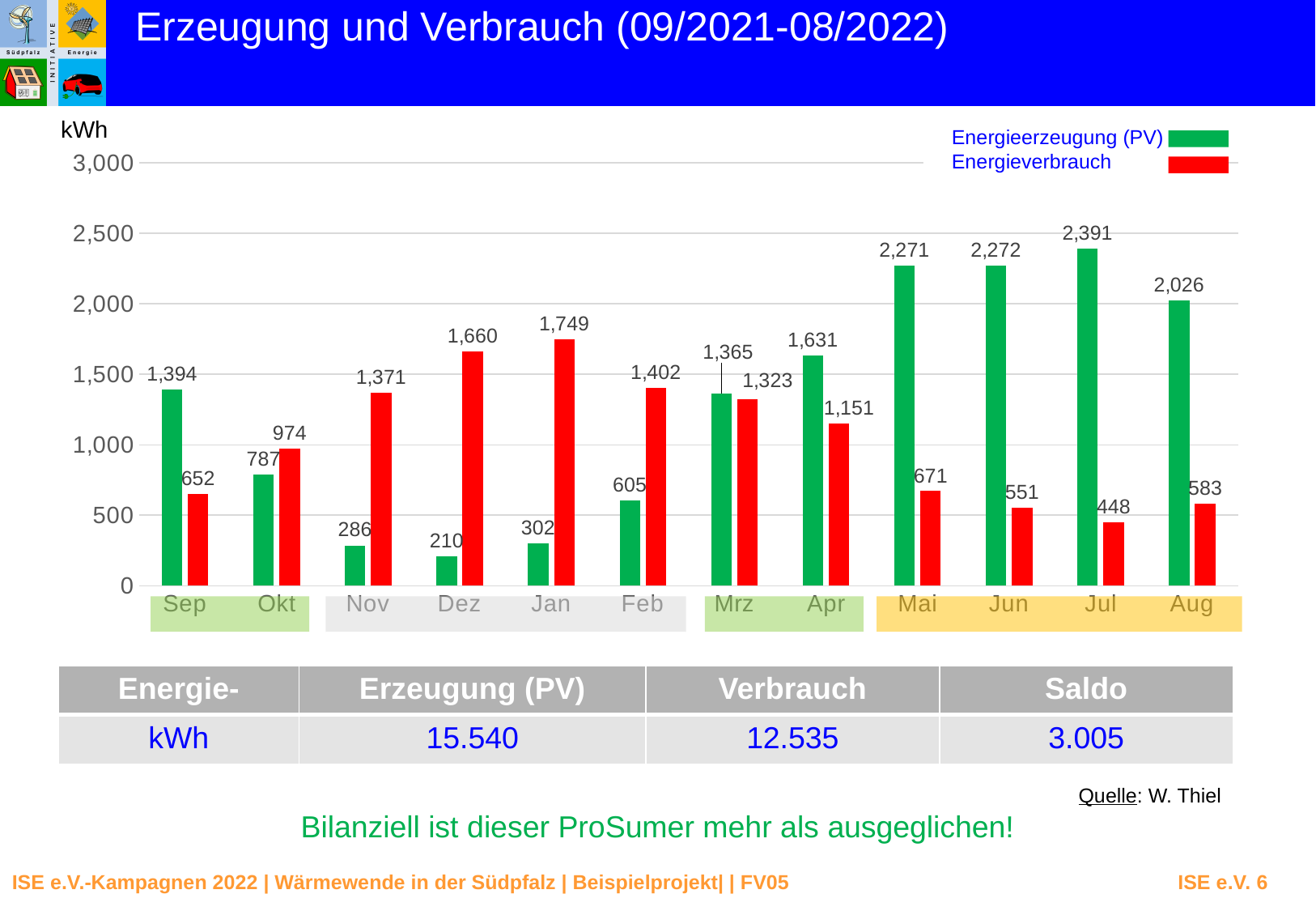
Which month has the lowest Energieverbrauch? Jul What kind of chart is shown on the slide? bar chart What is the Energieerzeugung (PV) value for Dez? 210 How many months are shown on the x axis? 12 What is the difference between Energieerzeugung (PV) and Energieverbrauch in Sep? 742 Which month has the highest Energieverbrauch? Jan How many series does the legend list? 2 What is the Energieerzeugung (PV) value for Jul? 2,391 In Nov, which is larger: Energieerzeugung (PV) or Energieverbrauch? Energieverbrauch Is the Energieerzeugung (PV) value for Aug greater or less than 2,000? greater What is the Energieverbrauch value for Jan? 1,749 Which month has the lowest Energieerzeugung (PV)? Dez